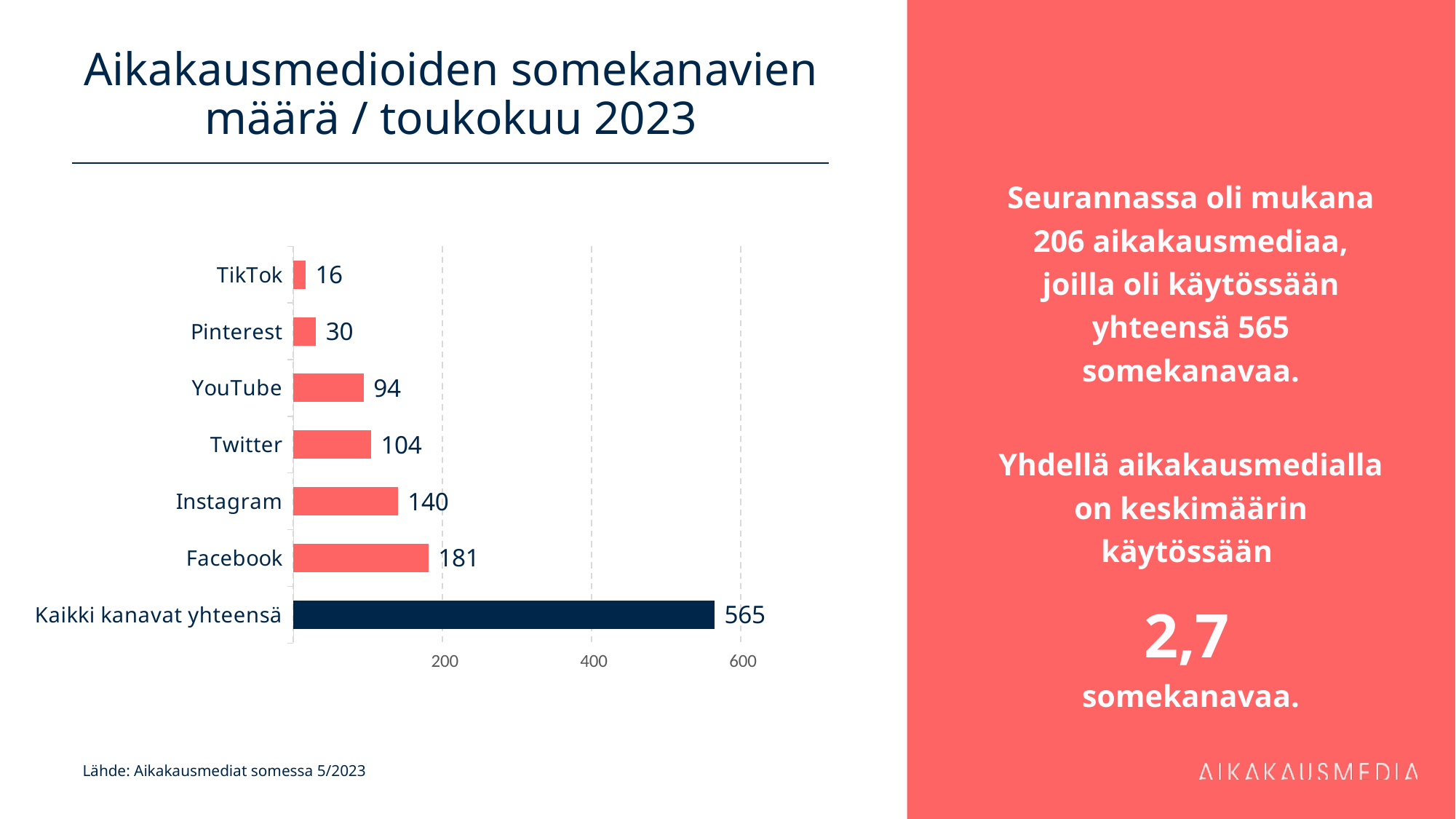
What is the title of the chart on the slide? Aikakausmedioiden somekanavien määrä / toukokuu 2023 Which category has the lowest value? TikTok What is the difference between the values for Twitter and YouTube? 10 What is the value for Instagram? 140 How many categories are shown in the chart? 7 What is the value for TikTok? 16 Which individual channel (excluding the total bar) has the highest value? Facebook What is the difference between the values for Facebook and Instagram? 41 Which is larger, the value for Pinterest or the value for YouTube? YouTube What kind of chart is shown on the slide? Bar chart What is the value for Kaikki kanavat yhteensä? 565 What is the value for Facebook? 181